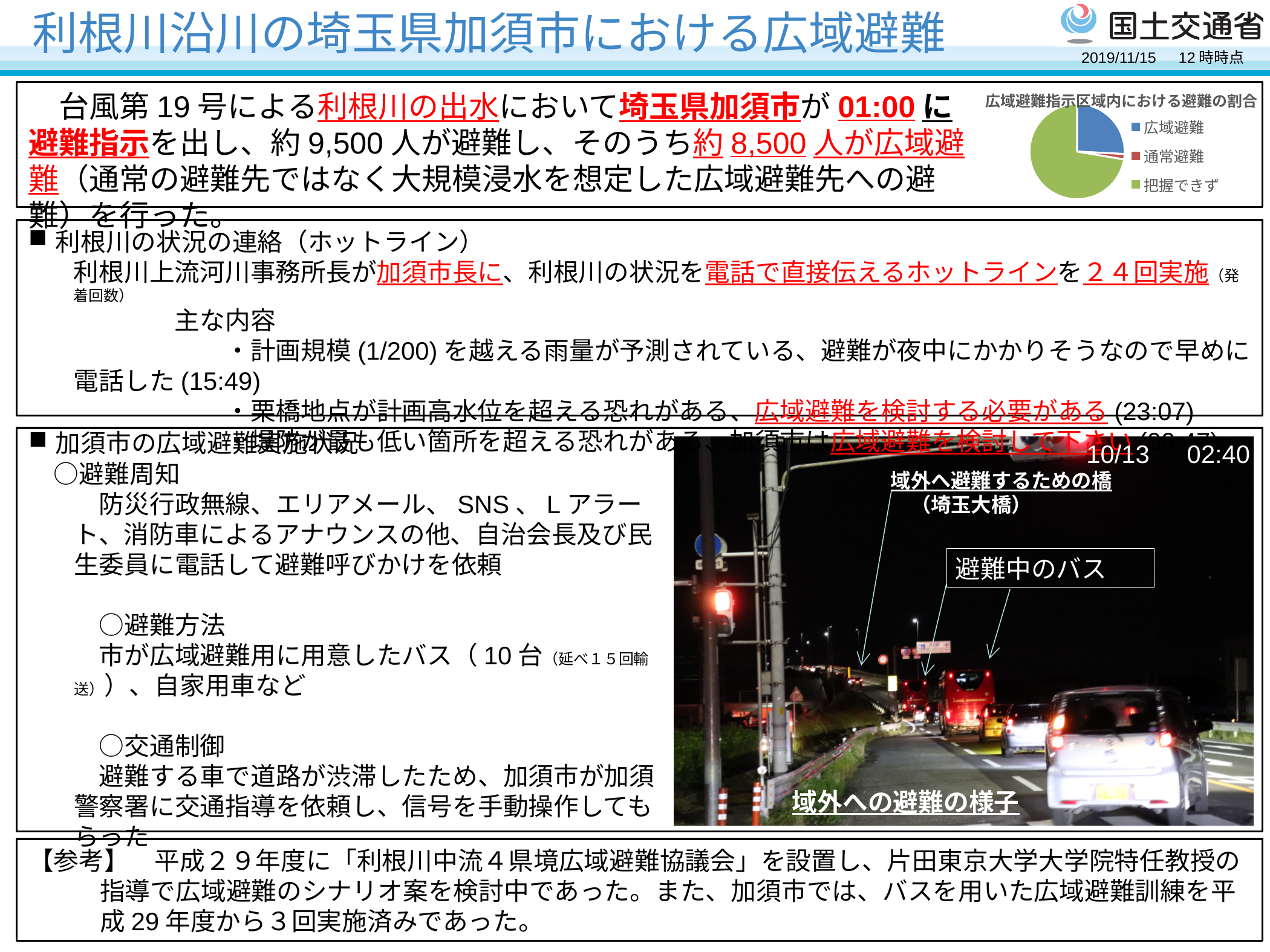
Which category has the smallest slice in the pie chart? 通常避難 In the pie chart, which slice is larger: 広域避難 or 通常避難? 広域避難 What is the title of the pie chart? 広域避難指示区域内における避難の割合 What colour represents 把握できず in the pie chart? green In the pie chart, which slice is larger: 広域避難 or 把握できず? 把握できず How many categories does the pie chart's legend list? 3 What kind of chart is shown in the top-right of the slide? pie chart Which category has the largest slice in the pie chart? 把握できず Which legend entry in the pie chart is shown in blue? 広域避難